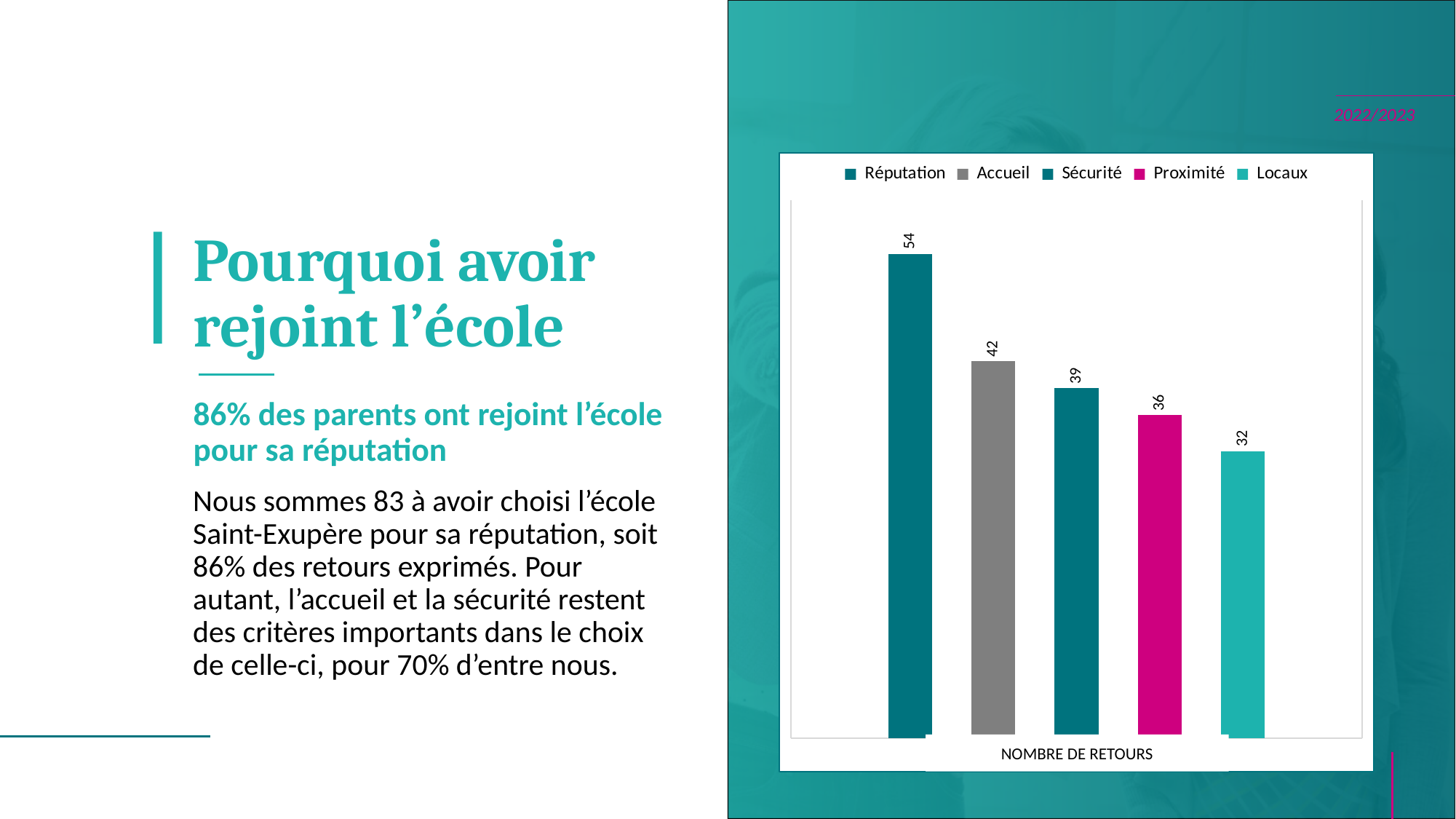
How many series does the legend list? 5 What is the value for Réputation? 54 What is the value for Accueil? 42 Which category has the highest value? Réputation What is the difference between the values for Réputation and Accueil? 12 What is the value for Proximité? 36 What is the value for Sécurité? 39 Which is larger, the value for Sécurité or the value for Proximité? Sécurité What kind of chart is shown? Bar chart Which category has the lowest value? Locaux What is the label shown below the bars on the x axis? NOMBRE DE RETOURS What is the value for Locaux? 32